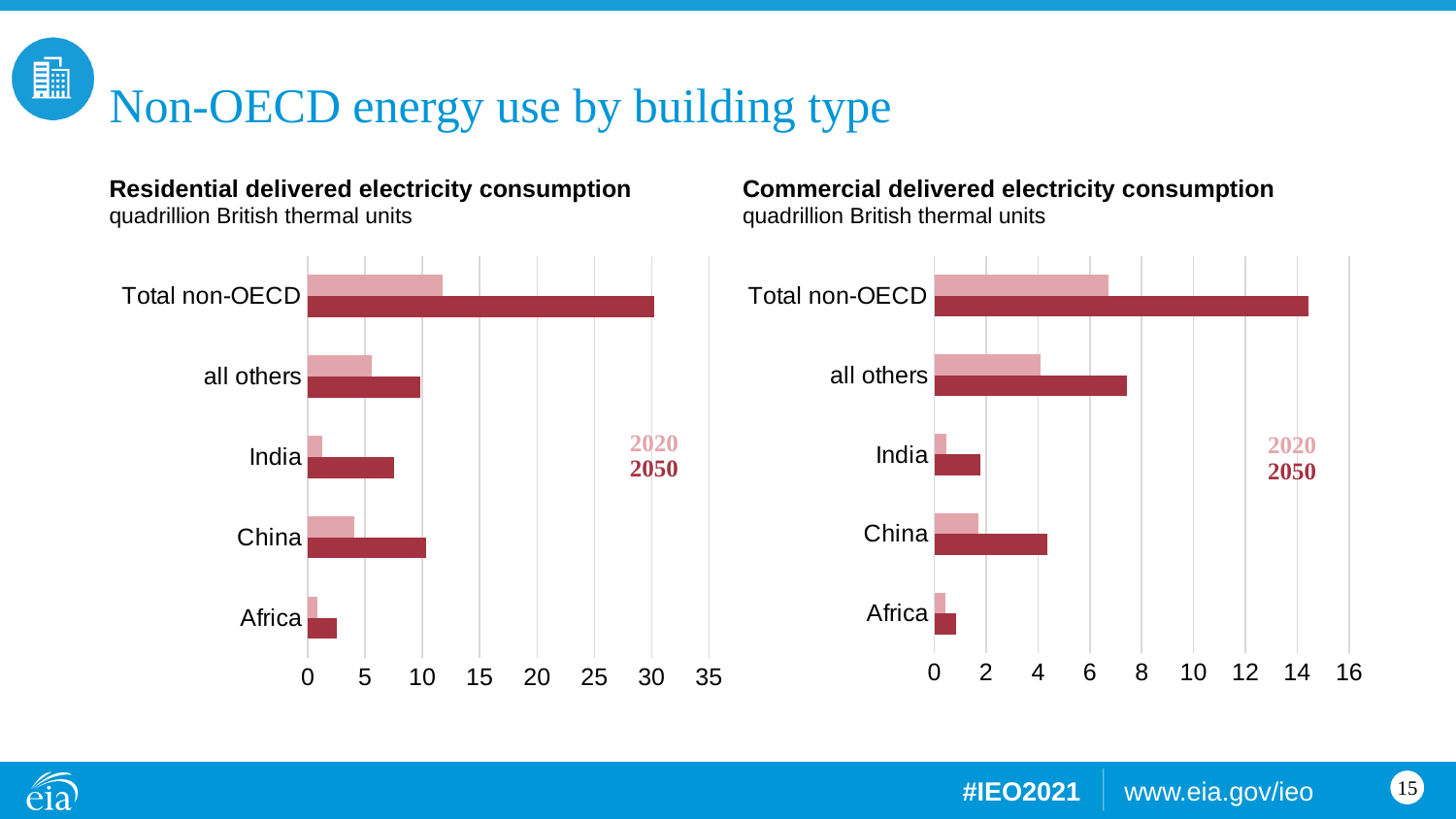
In the Residential delivered electricity consumption chart, is the 2050 value for Total non-OECD greater or less than 25? greater In the Residential delivered electricity consumption chart, which category has the lowest 2050 value? Africa In the Residential delivered electricity consumption chart, which is larger for 2050: India or China? China How many series does the legend of the Commercial delivered electricity consumption chart list? 2 In the Commercial delivered electricity consumption chart, which is larger for 2050: all others or China? all others How many categories are shown in the Residential delivered electricity consumption chart? 5 In the Residential delivered electricity consumption chart, is the 2050 value for Africa greater or less than 5? less In the Residential delivered electricity consumption chart, is the 2020 value for Total non-OECD greater or less than 15? less What type of chart is the Residential delivered electricity consumption chart? bar chart